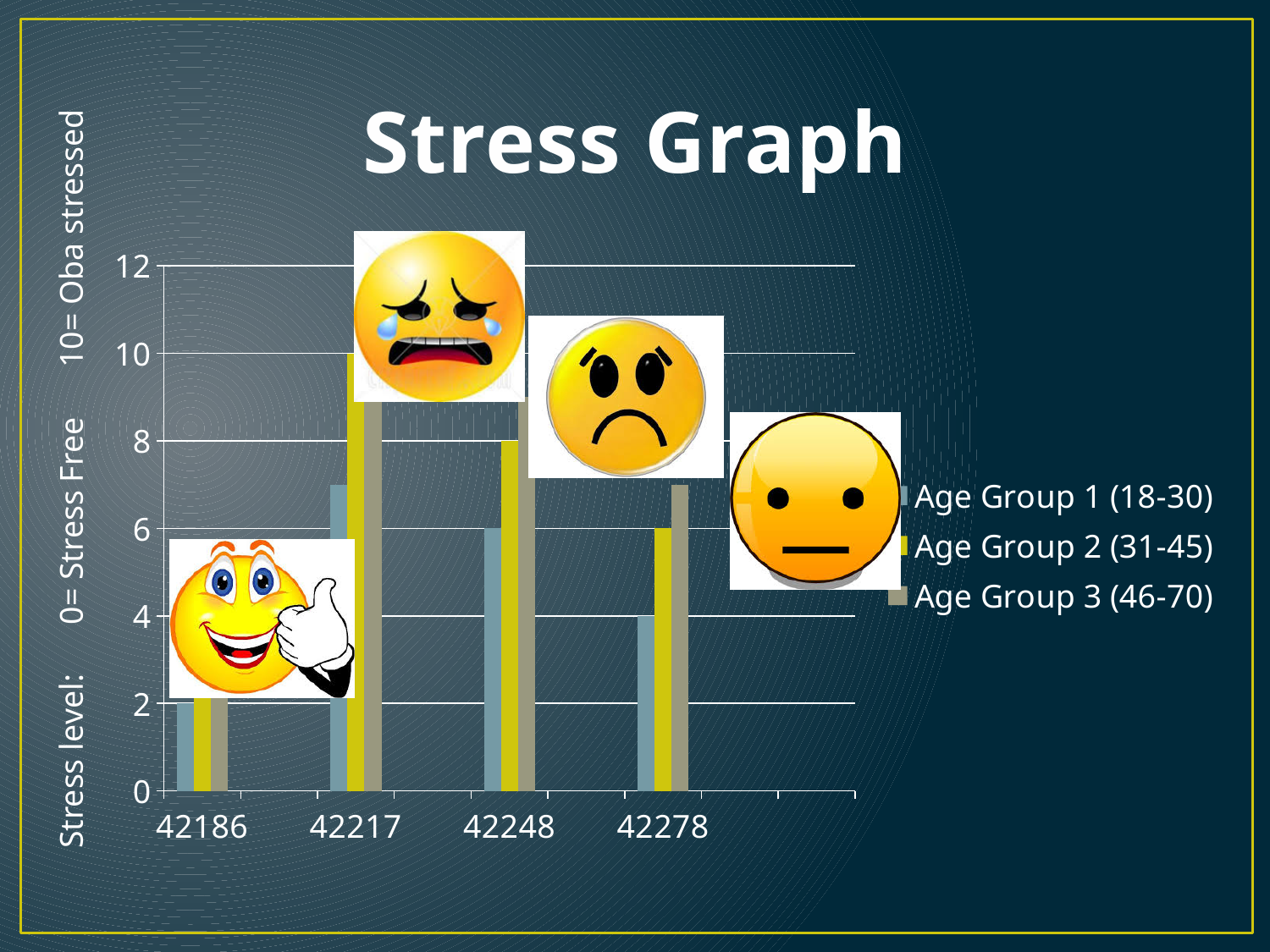
What kind of chart is shown on the slide? bar chart What is the value for Age Group 1 (18-30) at 42248? 6 How many categories are shown on the x axis? 4 What is the value for Age Group 1 (18-30) at 42278? 4 What is the value for Age Group 2 (31-45) at 42217? 10 What is the title of the chart? Stress Graph How many series does the legend list? 3 What is the value for Age Group 2 (31-45) at 42278? 6 Which is larger at 42248: Age Group 1 (18-30) or Age Group 2 (31-45)? Age Group 2 (31-45) Is the value for Age Group 3 (46-70) at 42278 greater or less than 6? greater Is the value for Age Group 1 (18-30) at 42217 greater or less than 6? greater At which category does Age Group 2 (31-45) reach its highest value? 42217